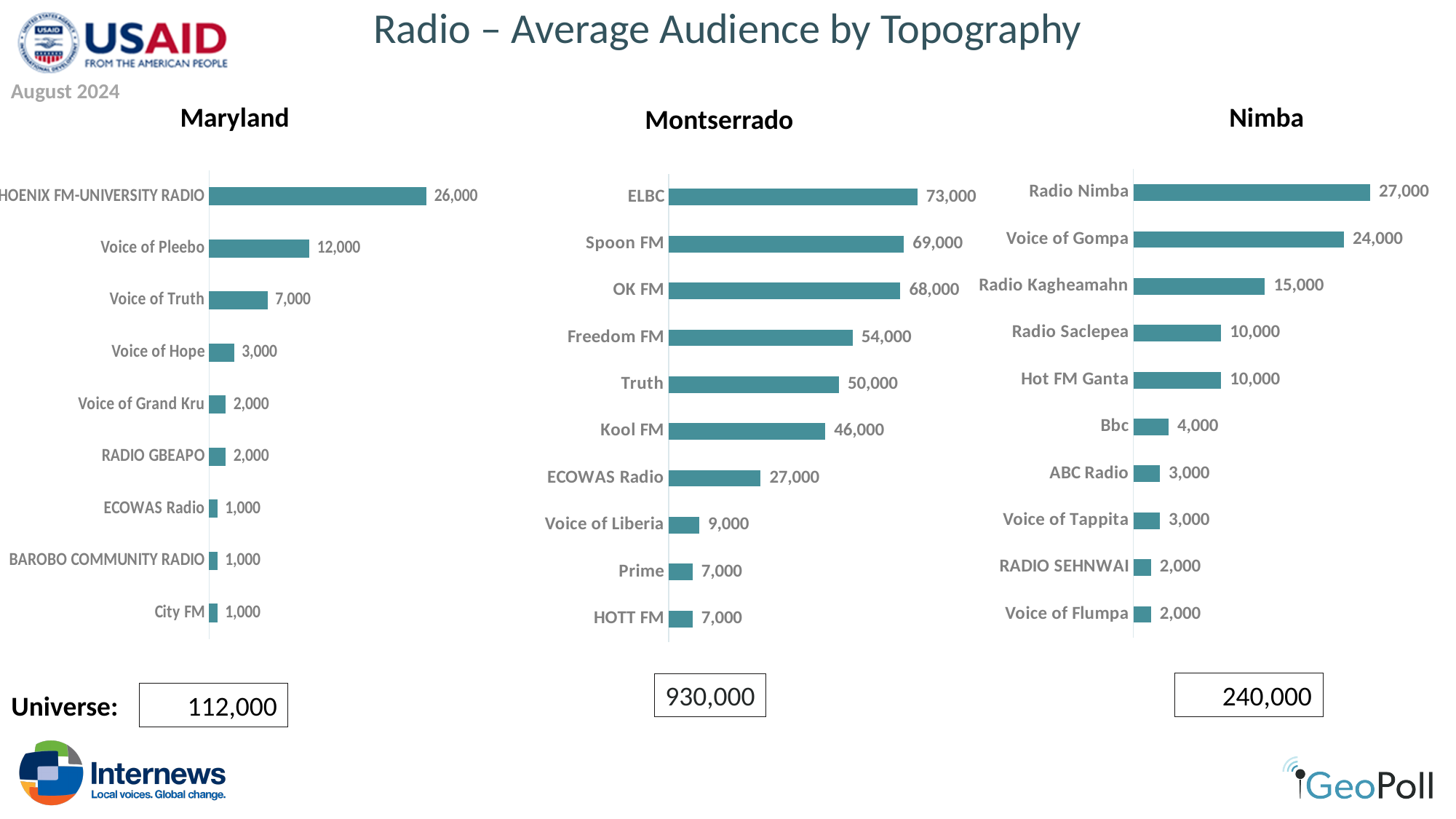
In the Montserrado chart, what is the average audience for ELBC? 73,000 In the Maryland chart, which station has the lowest average audience among Voice of Hope and Voice of Truth? Voice of Hope In the Montserrado chart, which station has the highest average audience? ELBC What is the Universe value shown for Montserrado? 930,000 In the Montserrado chart, what is the difference in average audience between ELBC and Spoon FM? 4,000 In the Nimba chart, what is the difference in average audience between Radio Nimba and Voice of Gompa? 3,000 In the Montserrado chart, which has a larger average audience, Freedom FM or Kool FM? Freedom FM In the Maryland chart, what is the average audience for Voice of Pleebo? 12,000 In the Nimba chart, which station has the highest average audience? Radio Nimba In the Nimba chart, what is the average audience for Radio Kagheamahn? 15,000 What type of chart is used for the Nimba data? Bar chart How many stations are shown in the Montserrado chart? 10